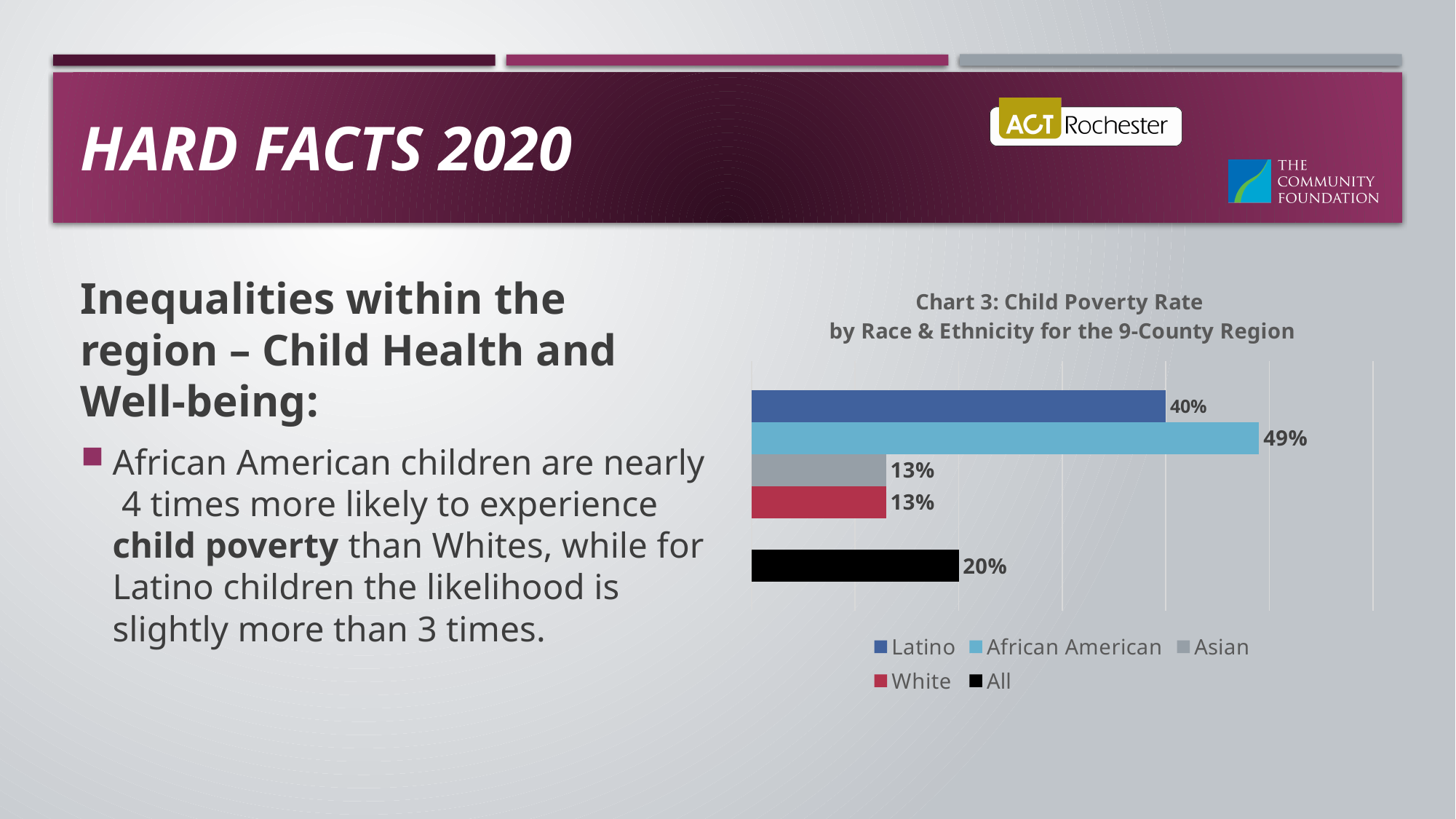
What is the child poverty rate for Latino children in the chart? 40% How many series does the chart legend list? 5 What kind of chart is shown on the slide? Bar chart What is the title of the chart on the slide? Chart 3: Child Poverty Rate by Race & Ethnicity for the 9-County Region What is the child poverty rate for White children in the chart? 13% What colour is the bar for All children in the chart? Black What is the child poverty rate for African American children in the chart? 49% What is the child poverty rate for All children in the chart? 20% Which is larger, the child poverty rate for Latino children or for All children? Latino What is the difference between the child poverty rate for African American children and White children? 36% What is the difference between the child poverty rate for Latino children and All children? 20% Which group has the highest child poverty rate in the chart? African American